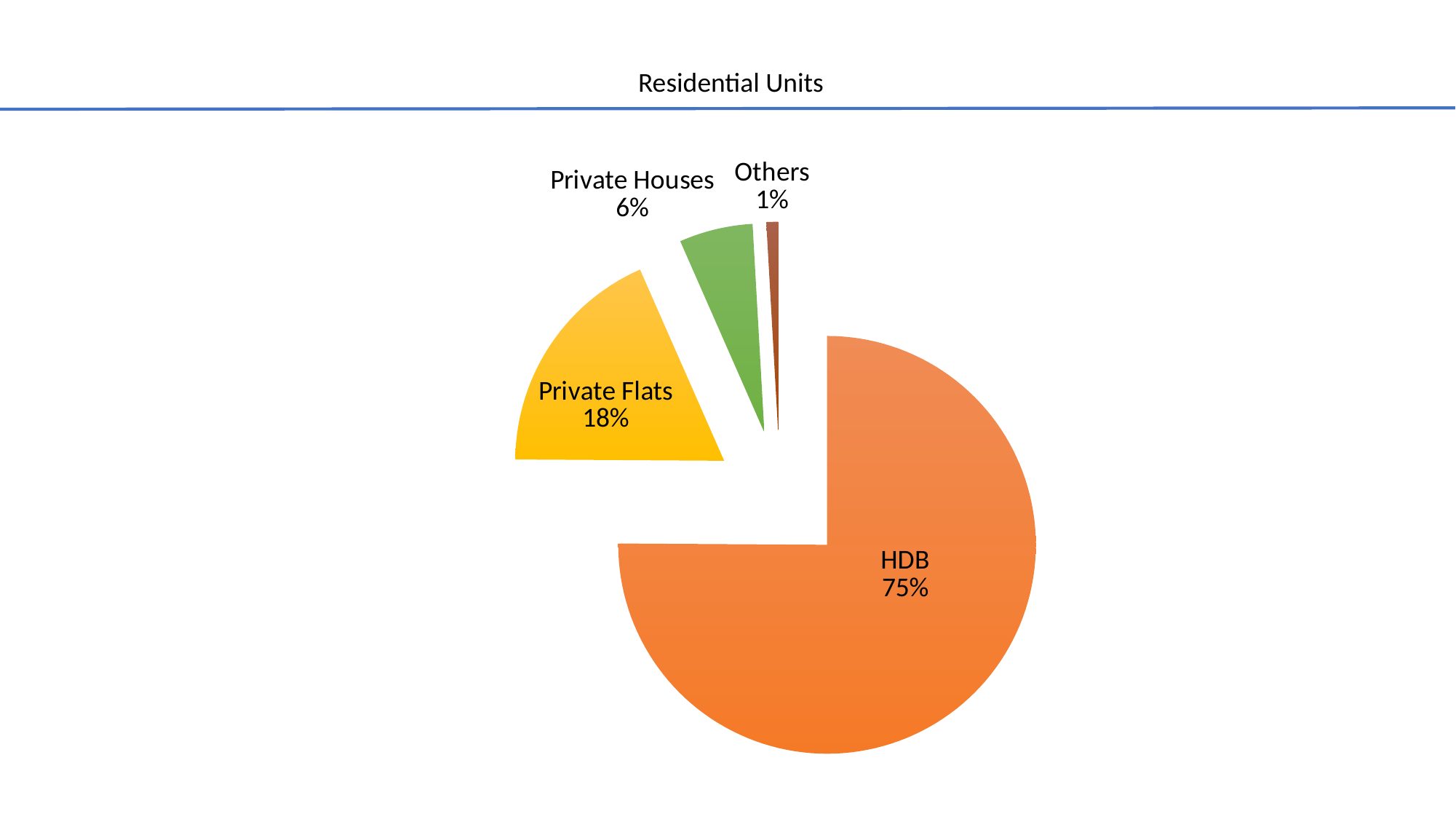
Which is larger, the share for Private Flats or the share for Private Houses? Private Flats What colour is the HDB slice? orange What is the difference in percentage points between HDB and Private Flats? 57 What share of residential units is Private Houses? 6% How many categories are shown in the pie chart? 4 What share of residential units is Private Flats? 18% What type of chart is shown on the slide? pie chart Which category has the largest share of the pie? HDB What share of residential units is HDB? 75% What is the title of the chart? Residential Units Which category has the smallest share of the pie? Others